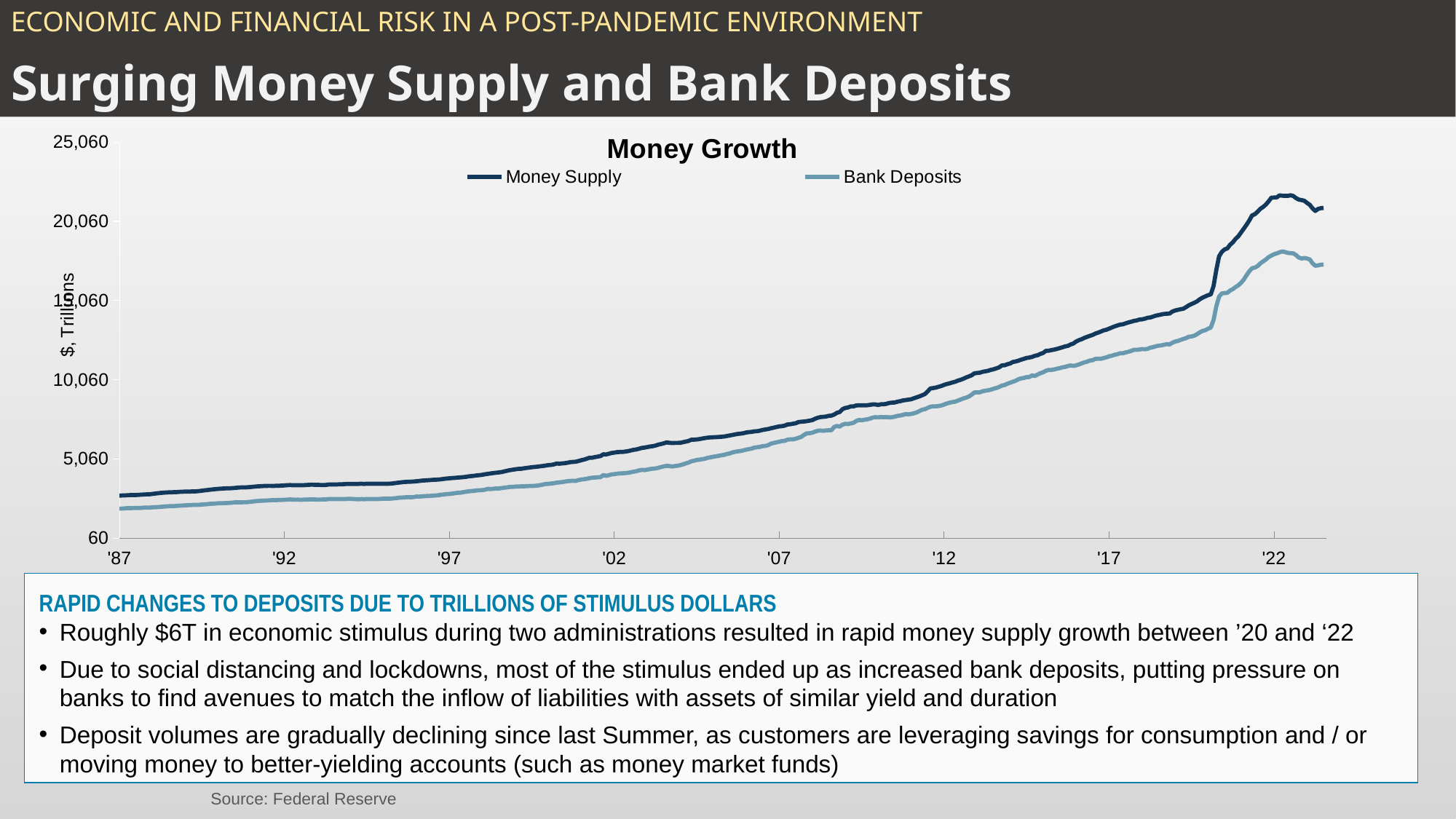
At '22, which series is higher, Money Supply or Bank Deposits? Money Supply Is the value for Bank Deposits at '22 greater or less than 20,060? less Is the value for Money Supply at '87 greater or less than 5,060? less Which two series are listed in the chart legend? Money Supply and Bank Deposits Does the Money Supply line generally rise or fall from '87 to '22? rise Is the value for Bank Deposits at '12 greater or less than 10,060? less How many series does the legend of the Money Growth chart list? 2 What is the title of the chart? Money Growth What kind of chart is shown on the slide? line chart Does the Bank Deposits line generally rise or fall from '87 to '22? rise